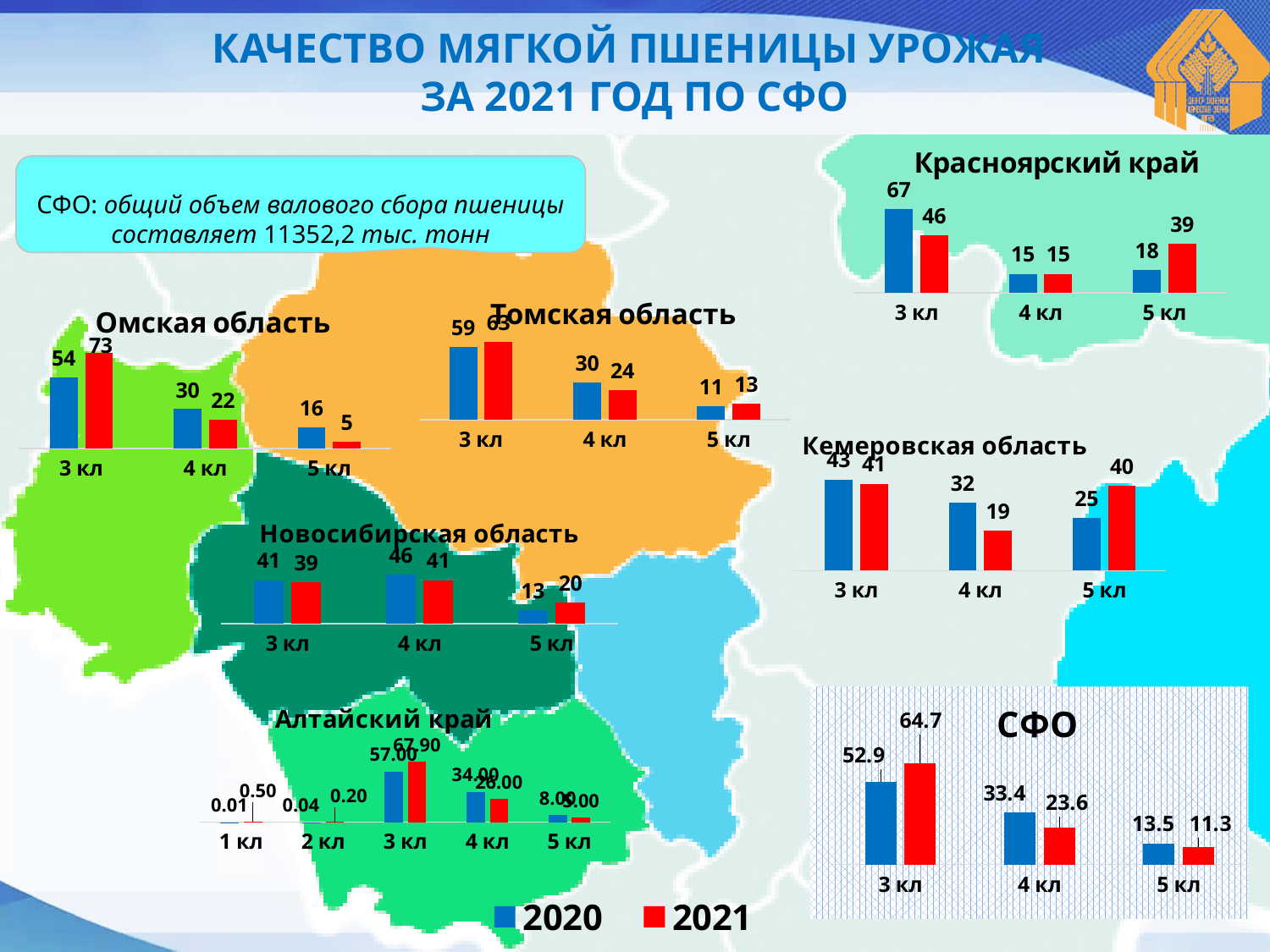
In the Омская область chart, what is the value for 2021 in the 3 кл category? 73 In the СФО chart, do the 2020 values rise or fall from 3 кл to 5 кл? Fall In the Кемеровская область chart, which category has the highest 2021 value? 3 кл How many series does the legend at the bottom of the slide list? 2 In the СФО chart, what is the value for 2021 in the 4 кл category? 23.6 In the Томская область chart, which category has the lowest 2020 value? 5 кл In the Красноярский край chart, what is the value for 2020 in the 3 кл category? 67 In the Новосибирская область chart, what is the difference between the 2020 and 2021 values for 5 кл? 7 In the Омская область chart, how many categories are shown on the x axis? 3 What type of chart is the СФО chart? Bar chart In the Красноярский край chart, which is larger for 5 кл: the 2020 value or the 2021 value? 2021 In the Алтайский край chart, how many categories are shown on the x axis? 5